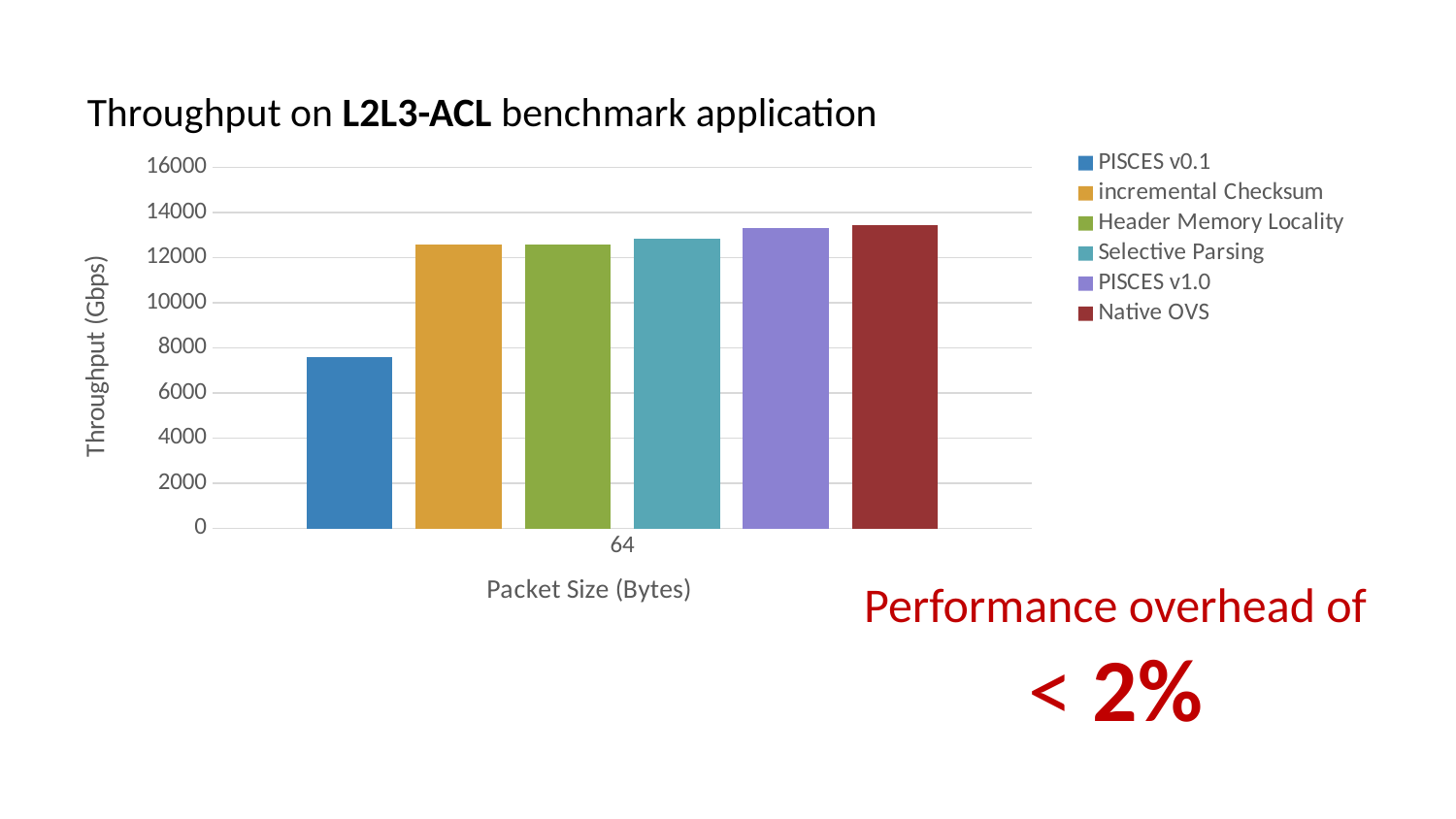
Which is larger, the throughput for PISCES v0.1 or for Header Memory Locality? Header Memory Locality How many packet-size categories are shown on the x axis? 1 Is the value for incremental Checksum greater or less than 12000? greater Which is larger, the throughput for PISCES v0.1 or for Native OVS? Native OVS Is the value for Native OVS greater or less than 14000? less How many series does the legend list? 6 What kind of chart is shown on the slide? bar chart Which series has the lowest throughput? PISCES v0.1 What is the label of the y axis? Throughput (Gbps) Is the value for PISCES v0.1 greater or less than 8000? less What packet size is shown on the x axis? 64